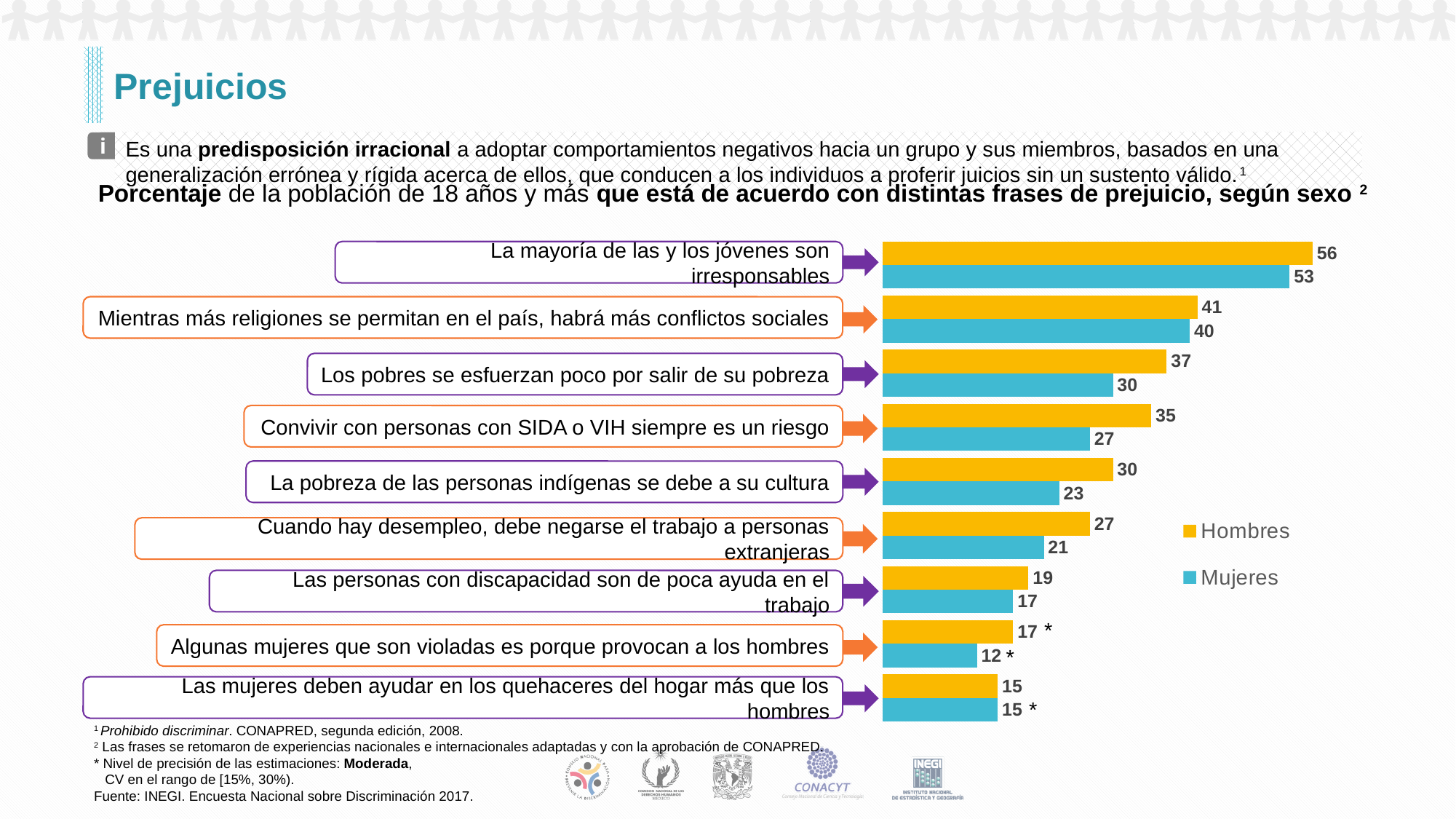
What is the value for Mujeres for the statement 'Los pobres se esfuerzan poco por salir de su pobreza'? 30 How many prejudice statements (categories) are plotted in the chart? 9 Which colour represents the Mujeres series in the chart? Blue What is the difference between the Hombres values for 'Mientras más religiones se permitan en el país, habrá más conflictos sociales' and 'Cuando hay desempleo, debe negarse el trabajo a personas extranjeras'? 14 What is the value for Hombres for the statement 'La mayoría de las y los jóvenes son irresponsables'? 56 What type of chart is shown on the slide? Bar chart Which statement has the highest value for Hombres? La mayoría de las y los jóvenes son irresponsables Which statement has the lowest value for Hombres? Las mujeres deben ayudar en los quehaceres del hogar más que los hombres How many series does the legend list? 2 For 'La pobreza de las personas indígenas se debe a su cultura', which is larger, the Hombres value or the Mujeres value? Hombres What is the difference between the Hombres and Mujeres values for 'Convivir con personas con SIDA o VIH siempre es un riesgo'? 8 What is the value for Mujeres for the statement 'Algunas mujeres que son violadas es porque provocan a los hombres'? 12